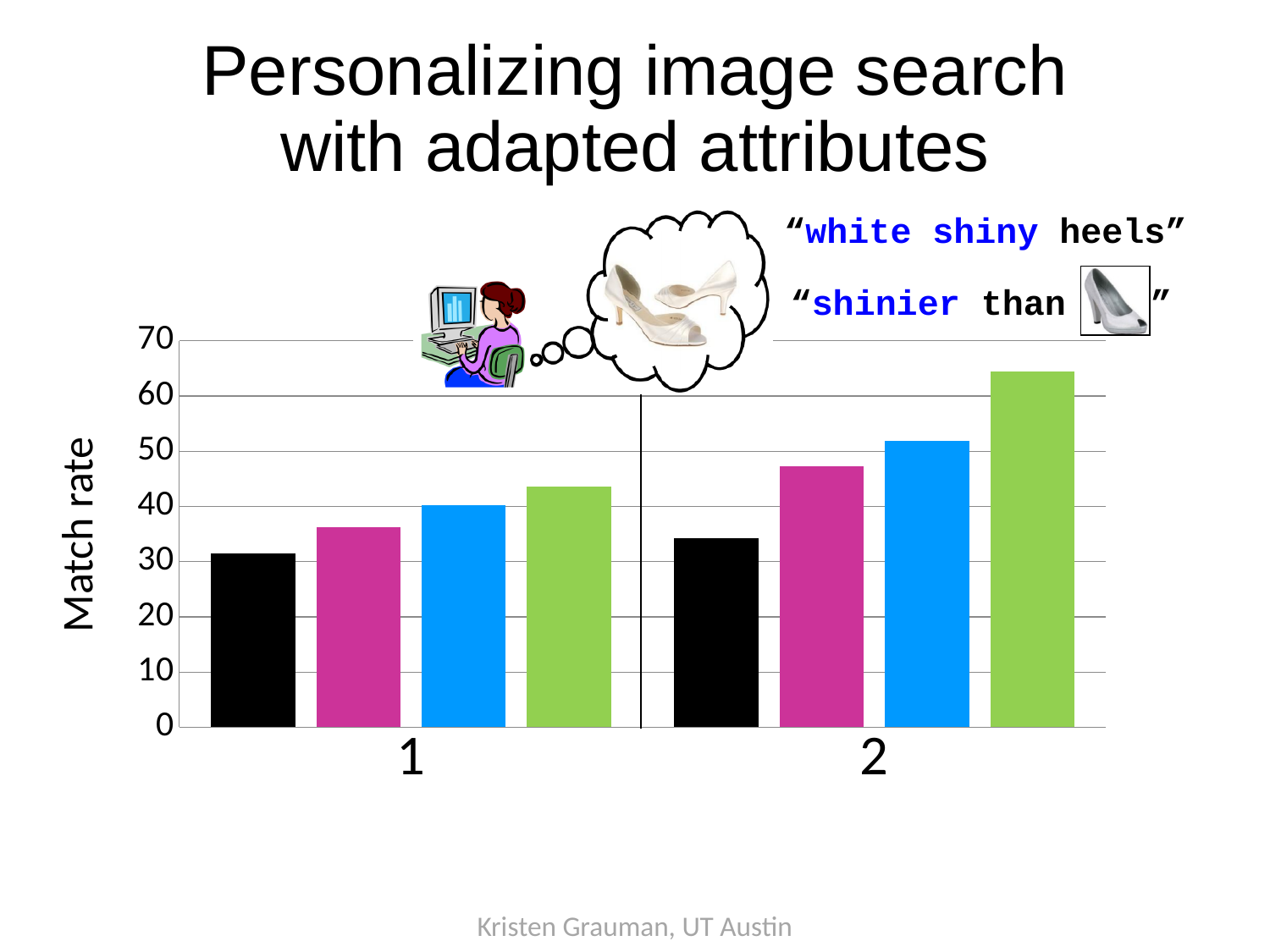
What colours are the four bars in each category, from left to right? black, magenta, blue, green How many categories are shown on the x axis of the chart? 2 Is the value of the magenta bar in category 2 greater or less than 50? less What kind of chart is shown on the slide? bar chart How many bars are plotted for each category on the chart? 4 Which is larger, the green bar in category 1 or the green bar in category 2? the green bar in category 2 Which bar on the chart is the tallest overall? the green bar in category 2 What is the label of the y axis of the chart? Match rate Which bar on the chart is the shortest overall? the black bar in category 1 Do the values for each bar colour rise or fall from category 1 to category 2? rise Is the value of the green bar in category 2 greater or less than 60? greater Is the value of the black bar in category 1 greater or less than 40? less